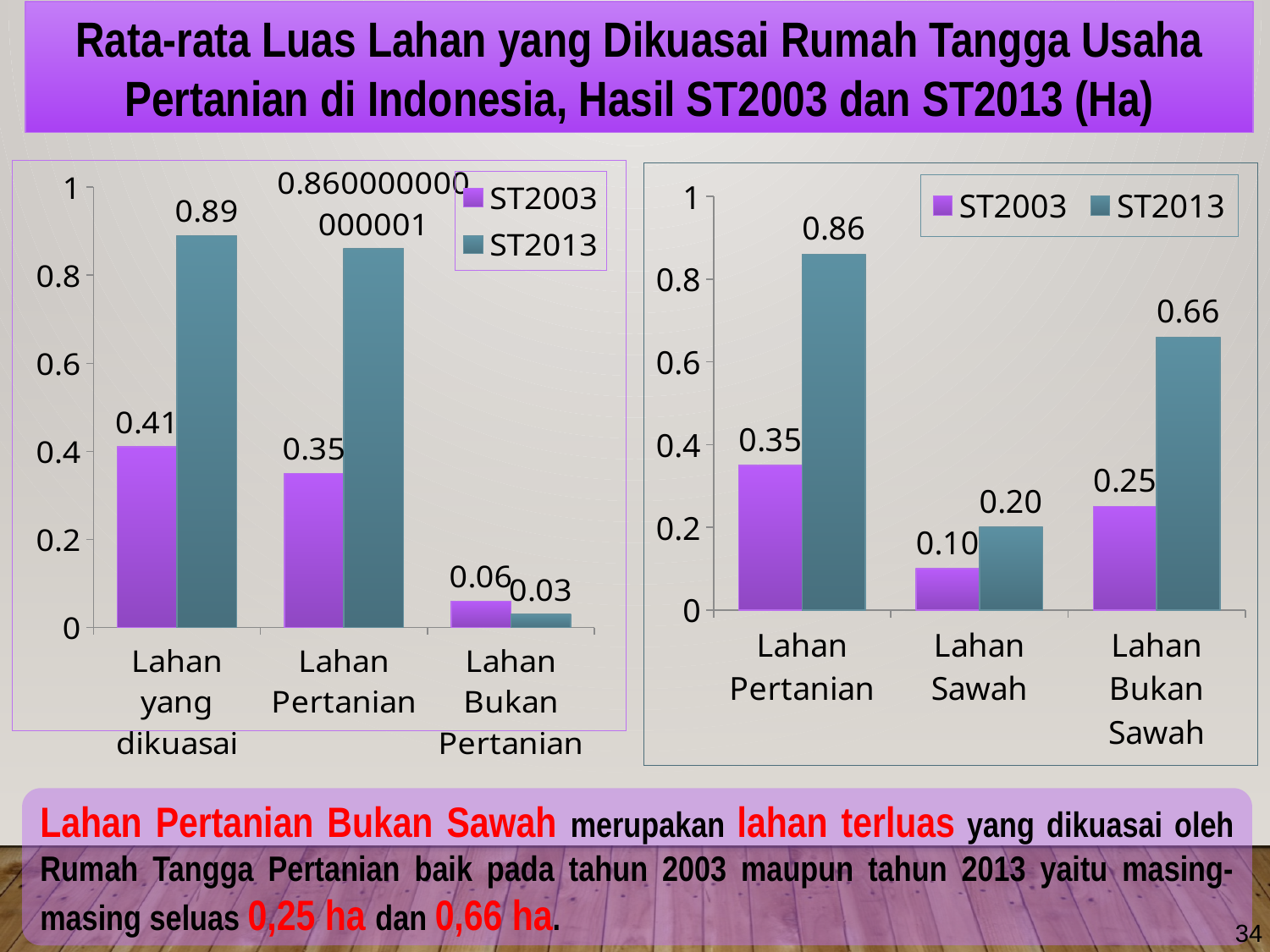
In the left chart, which is larger for Lahan Bukan Pertanian, ST2003 or ST2013? ST2003 In the right chart, what is the difference between the ST2013 and ST2003 values for Lahan Bukan Sawah? 0.41 In the left chart, what is the ST2003 value for Lahan Bukan Pertanian? 0.06 In the left chart, what is the ST2003 value for Lahan yang dikuasai? 0.41 In the right chart, what is the ST2013 value for Lahan Bukan Sawah? 0.66 In the right chart, which category has the lowest ST2013 value? Lahan Sawah In the left chart, what is the ST2013 value for Lahan yang dikuasai? 0.89 What type of chart is the right chart? Bar chart In the left chart, what is the difference between the ST2013 and ST2003 values for Lahan yang dikuasai? 0.48 In the right chart, what is the ST2003 value for Lahan Sawah? 0.10 How many categories are shown on the x axis of the right chart? 3 How many series does the legend of the left chart list? 2